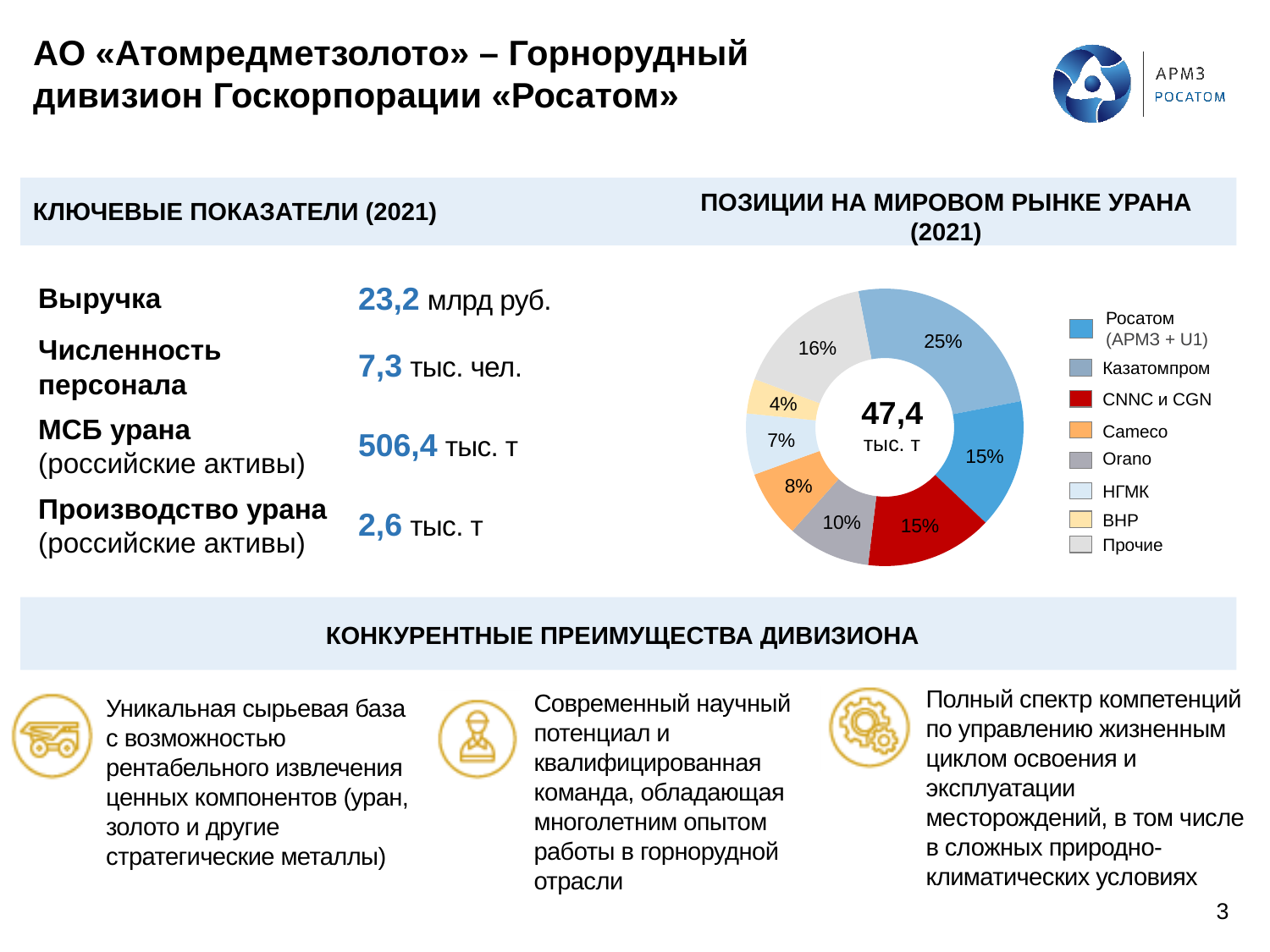
In the pie chart, what share is shown for Прочие? 16% What total value is printed in the centre of the pie chart? 47,4 тыс. т In the pie chart, how many percentage points larger is the Казатомпром share than the Росатом (АРМЗ + U1) share? 10 In the pie chart, what share is shown for Orano? 10% In the pie chart, what share is shown for Росатом (АРМЗ + U1)? 15% In the pie chart, what share is shown for Казатомпром? 25% How many categories does the legend of the pie chart list? 8 What kind of chart is shown under «ПОЗИЦИИ НА МИРОВОМ РЫНКЕ УРАНА (2021)»? Pie (donut) chart Which category has the largest slice in the pie chart? Казатомпром In the pie chart, which is larger: the share for НГМК or the share for BHP? НГМК In the pie chart, what share is shown for Cameco? 8% Which category has the smallest slice in the pie chart? BHP